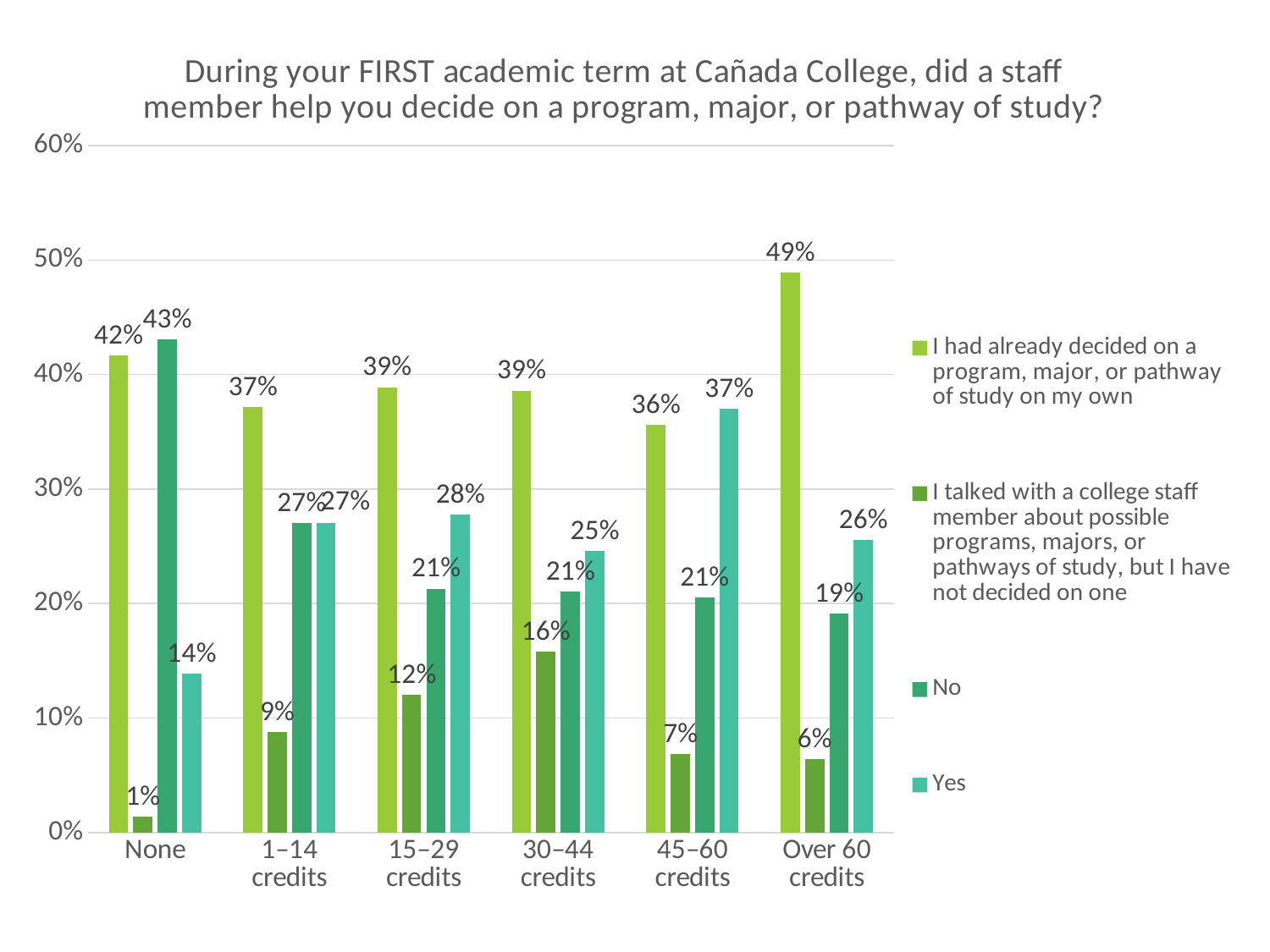
Which category has the lowest value for "I talked with a college staff member about possible programs, majors, or pathways of study, but I have not decided on one"? None Is the "Yes" value for the 1–14 credits category greater or less than 20%? greater What is the value for "I had already decided on a program, major, or pathway of study on my own" in the Over 60 credits category? 49% How many credit categories are shown on the x axis? 6 What is the difference between the "Yes" value and the "No" value in the 45–60 credits category? 16% What kind of chart is shown on the slide? Bar chart What is the highest value shown on the y axis? 60% How many series does the legend list? 4 In the 30–44 credits category, which is larger: the "Yes" value or the "No" value? Yes What is the value for "Yes" in the None category? 14% What is the value for "No" in the 15–29 credits category? 21% Which category has the highest value for "I had already decided on a program, major, or pathway of study on my own"? Over 60 credits